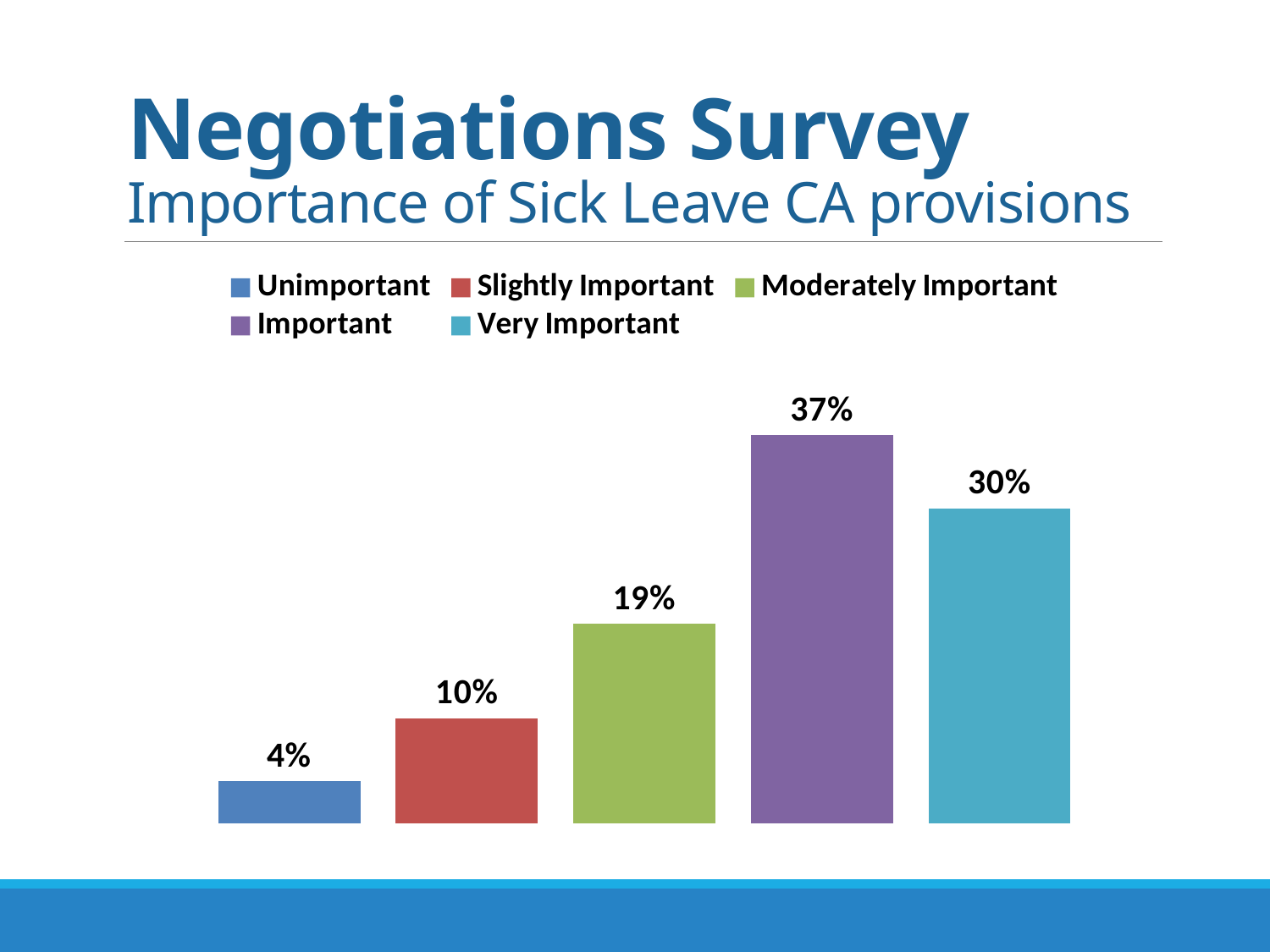
What percentage of respondents rated Sick Leave CA provisions as Important? 37% What is the value shown for Moderately Important? 19% What kind of chart is shown on the slide? Bar chart What is the value shown for Very Important? 30% What is the difference between the Moderately Important and Slightly Important values? 9% What is the value shown for Unimportant? 4% Which is larger, the value for Slightly Important or the value for Moderately Important? Moderately Important What is the difference between the Important and Very Important values? 7% Which category has the highest value? Important Which category has the lowest value? Unimportant How many bars are shown in the chart? 5 How many entries does the legend list? 5